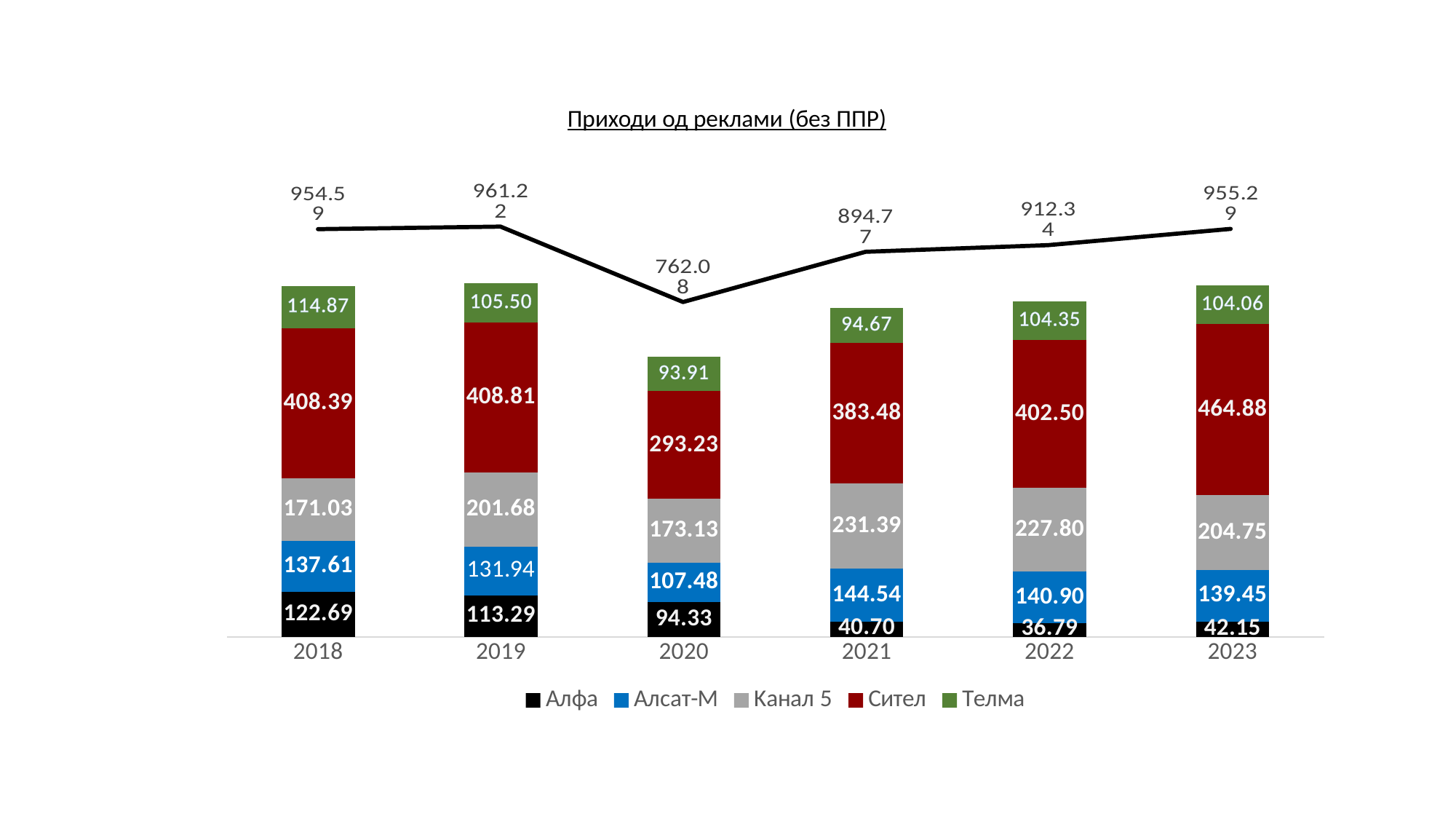
How many years are shown on the x axis? 6 What is the title of the chart? Приходи од реклами (без ППР) What is the value for Алфа in 2020? 94.33 Which is larger, the Канал 5 value in 2019 or in 2022? 2022 What is the difference between the Алсат-М values in 2021 and 2020? 37.06 What kind of chart is this? Stacked bar chart with a line How many series does the legend list? 5 In which year is the Сител segment the lowest? 2020 What is the value for Сител in 2023? 464.88 What is the total of the stacked bar for 2020? 762.08 In which year is the Телма segment the highest? 2018 What is the value for Канал 5 in 2021? 231.39